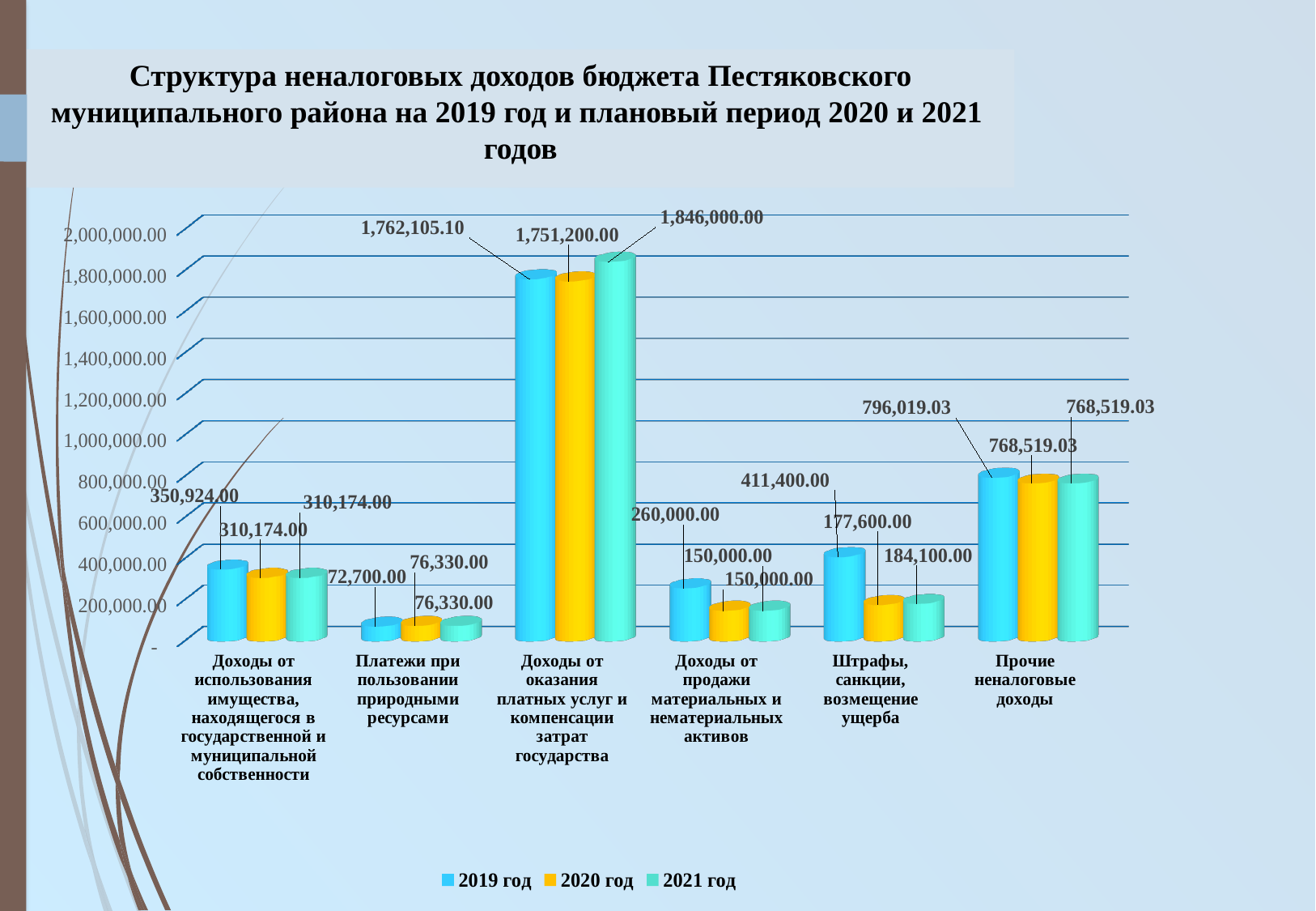
What is the value for 2019 год for Платежи при пользовании природными ресурсами? 72,700.00 Is the 2019 год value for Прочие неналоговые доходы greater or less than 600,000.00? greater What is the value for 2019 год for Доходы от оказания платных услуг и компенсации затрат государства? 1,762,105.10 Which category has the lowest value for 2019 год? Платежи при пользовании природными ресурсами Which category has the highest value for 2021 год? Доходы от оказания платных услуг и компенсации затрат государства What is the value for 2021 год for Прочие неналоговые доходы? 768,519.03 What is the difference between the 2021 год and 2020 год values for Доходы от оказания платных услуг и компенсации затрат государства? 94,800.00 What is the value for 2020 год for Доходы от продажи материальных и нематериальных активов? 150,000.00 What is the difference between the 2019 год and 2020 год values for Прочие неналоговые доходы? 27,500.00 For Доходы от использования имущества, находящегося в государственной и муниципальной собственности, which is larger: the 2019 год value or the 2020 год value? 2019 год How many series does the legend list? 3 How many categories are shown on the x axis? 6